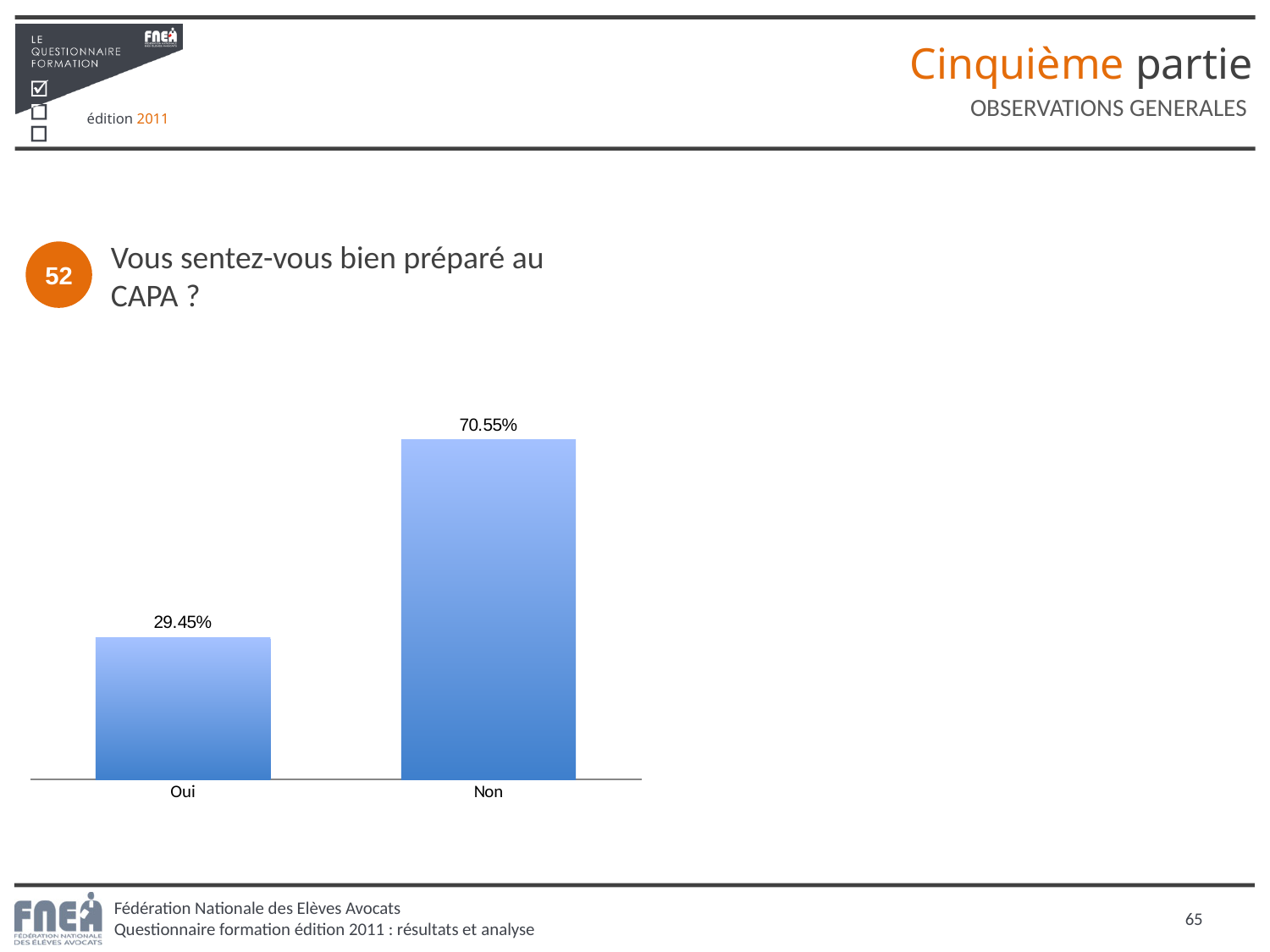
What is the number of the question shown next to the chart? 52 What is the difference between the values for "Non" and "Oui"? 41.10% Which category has the lowest value? Oui Which category has the highest value? Non Which is larger, the value for "Oui" or the value for "Non"? Non What is the total of the two values shown in the chart? 100.00% What question does the chart on the slide relate to? Vous sentez-vous bien préparé au CAPA ? How many categories are shown in the chart? 2 What kind of chart is shown on the slide? Bar chart What is the value for "Oui"? 29.45% What is the value for "Non"? 70.55%